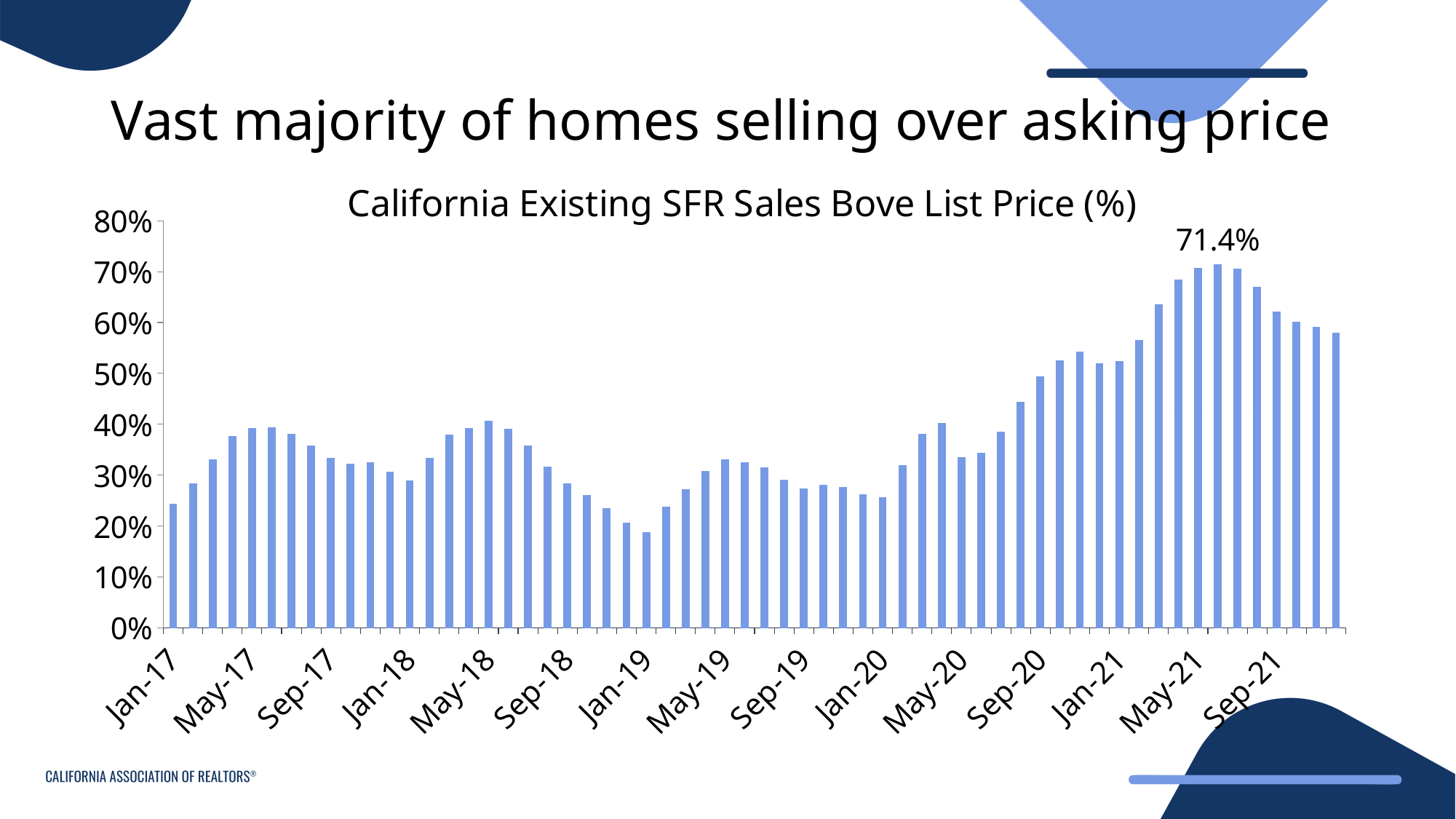
Is the value for Sep-21 greater or less than 50%? greater What is the highest value shown on the chart, as printed on its data label? 71.4% Is the value for Jan-17 greater or less than 30%? less What is the highest value shown on the vertical axis? 80% Is the value for May-21 greater or less than 60%? greater Which is larger, the value for Jan-19 or the value for Jan-20? Jan-20 Which is larger, the value for Jan-17 or the value for Jan-21? Jan-21 Do the values rise or fall from Jan-21 to May-21? rise What is the title of the chart? California Existing SFR Sales Bove List Price (%) What kind of chart is shown on the slide? bar chart Which month has the lowest bar on the chart? Jan-19